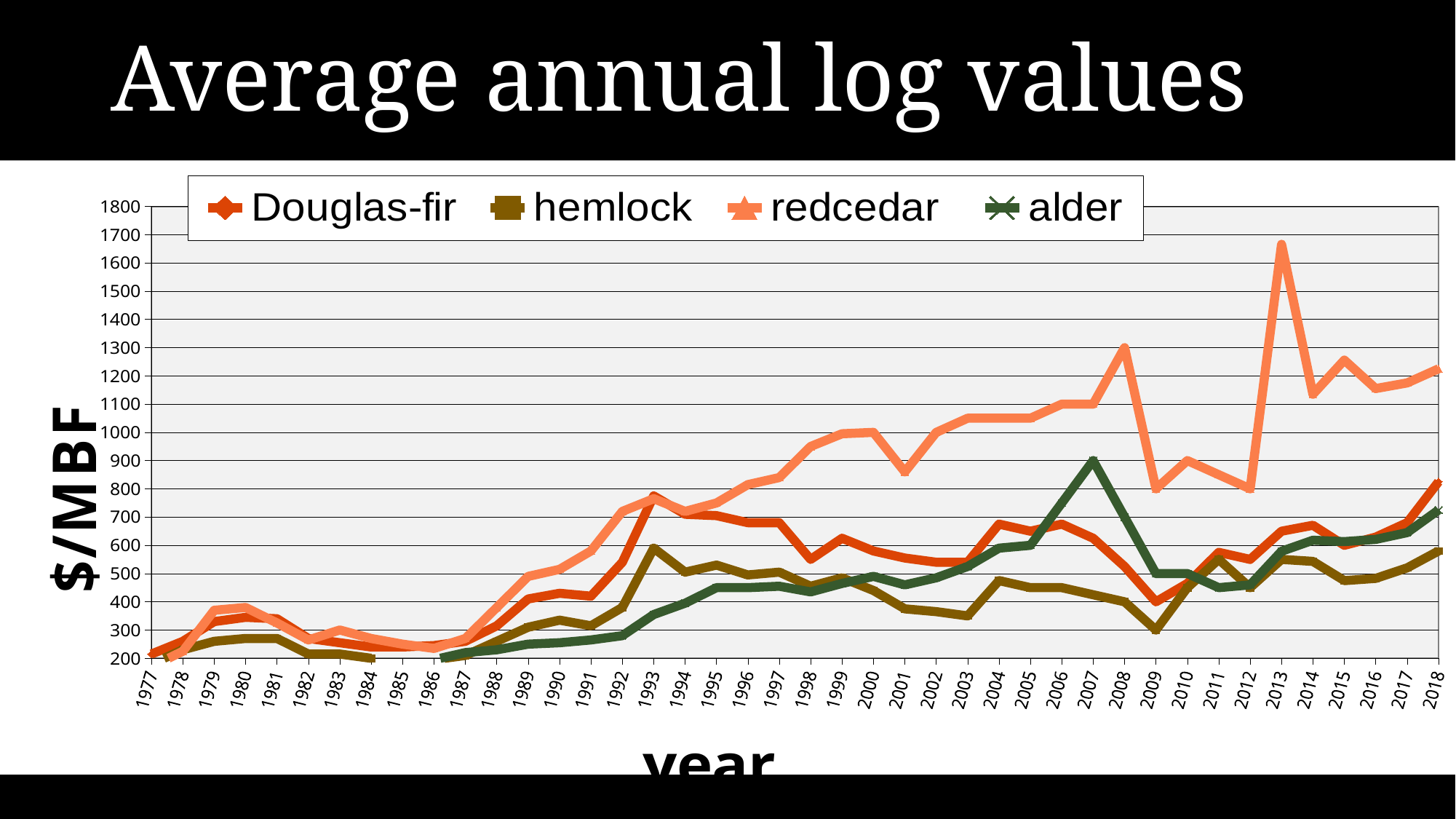
What kind of chart is shown on the slide? line chart In 2007, which is larger: the alder value or the Douglas-fir value? alder Which series has the lowest value in 2018? hemlock Is the value for alder in 2007 greater or less than 800? greater Which series has the highest value in 2013? redcedar Overall, does the redcedar series rise or fall from 1977 to 2018? rise How many series does the legend list? 4 What is the label on the y axis? $/MBF Is the value for redcedar in 2013 greater or less than 1500? greater How many years are plotted along the x axis? 42 In which year does the redcedar series reach its peak? 2013 Is the value for hemlock in 2009 greater or less than 400? less